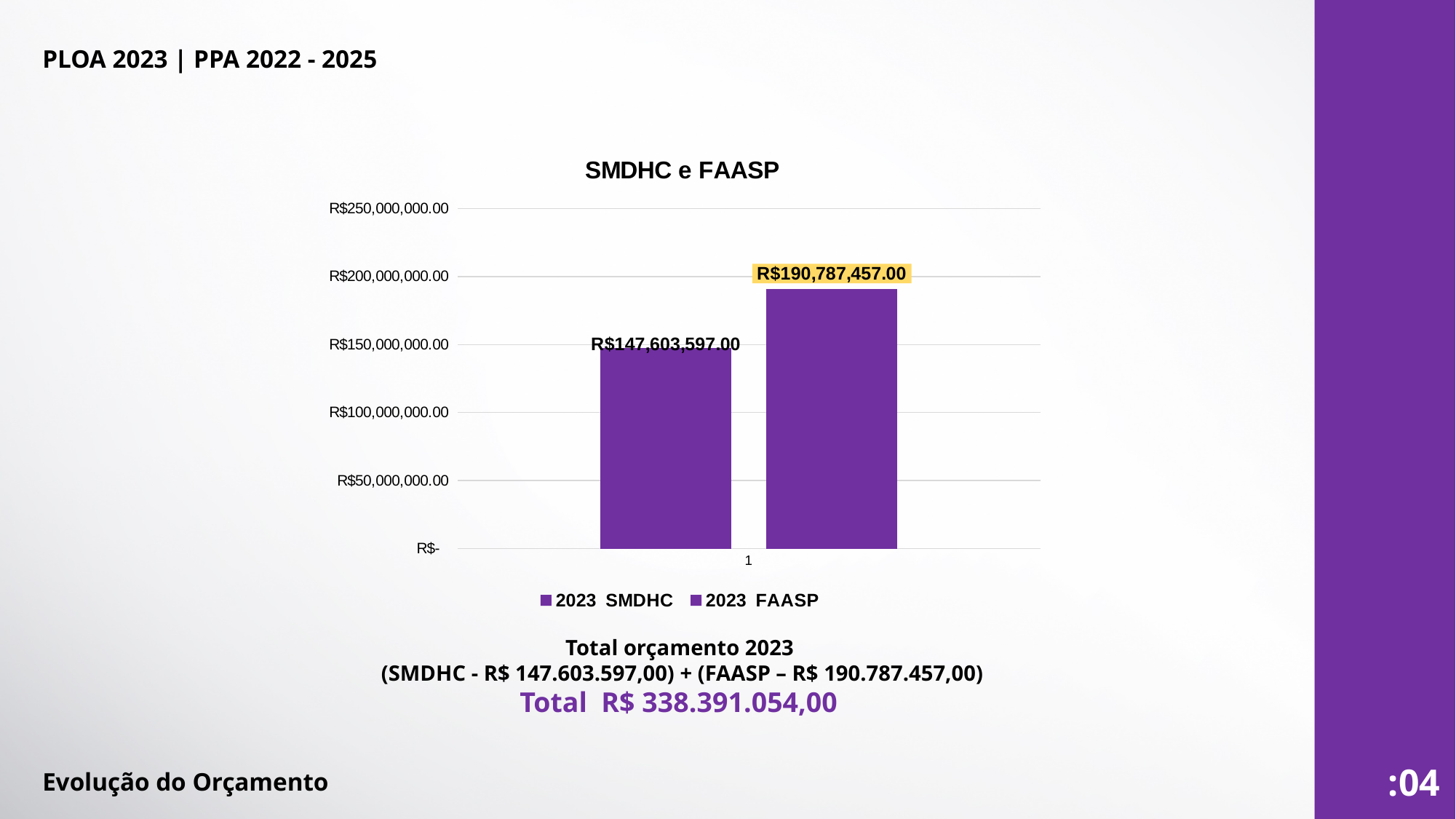
What is the difference between the 2023 FAASP value and the 2023 SMDHC value? R$43,183,860.00 What is the value of the 2023 SMDHC bar? R$147,603,597.00 Which bar is the highest in the chart? 2023 FAASP What is the title of the chart? SMDHC e FAASP What kind of chart is shown on the slide? Bar chart Which series has the higher value, 2023 SMDHC or 2023 FAASP? 2023 FAASP Is the value for 2023 SMDHC greater or less than R$150,000,000.00? less How many series does the legend list? 2 Is the value for 2023 FAASP greater or less than R$200,000,000.00? less What is the combined total of the 2023 SMDHC and 2023 FAASP values? R$ 338.391.054,00 What is the value of the 2023 FAASP bar? R$190,787,457.00 Which bar is the lowest in the chart? 2023 SMDHC